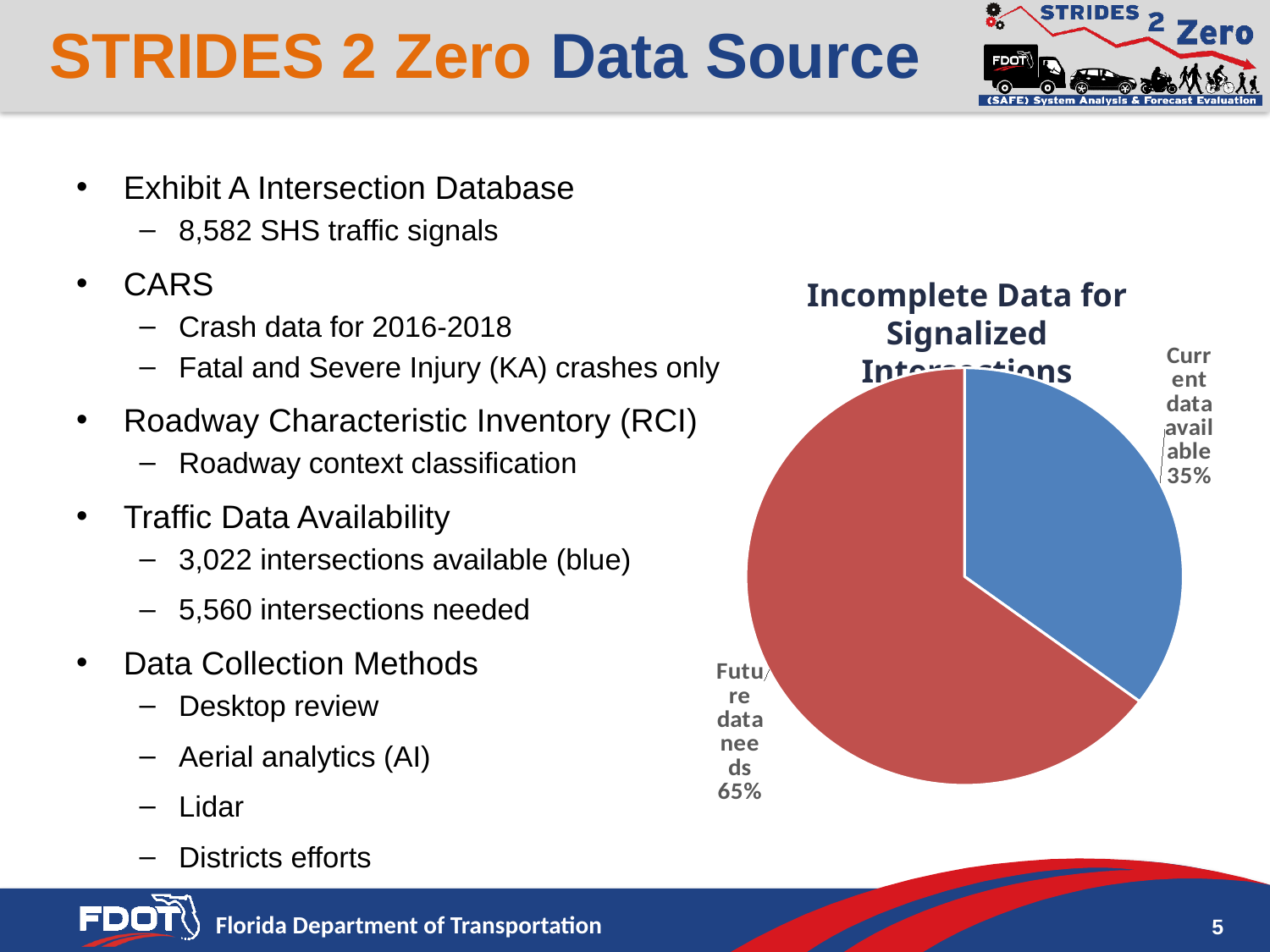
What colour is the "Current data available" slice of the pie chart? blue How many slices does the pie chart have? 2 What is the difference in percentage points between the "Future data needs" slice and the "Current data available" slice? 30 percentage points What share of the pie is labelled "Current data available"? 35% What kind of chart is shown on the slide? pie chart Which slice of the pie chart is the smallest? Current data available Is the share for "Current data available" greater or less than 50%? less What share of the pie is labelled "Future data needs"? 65% Which slice of the pie chart is the largest? Future data needs Which is larger, the "Current data available" slice or the "Future data needs" slice? Future data needs What is the title of the pie chart? Incomplete Data for Signalized Intersections